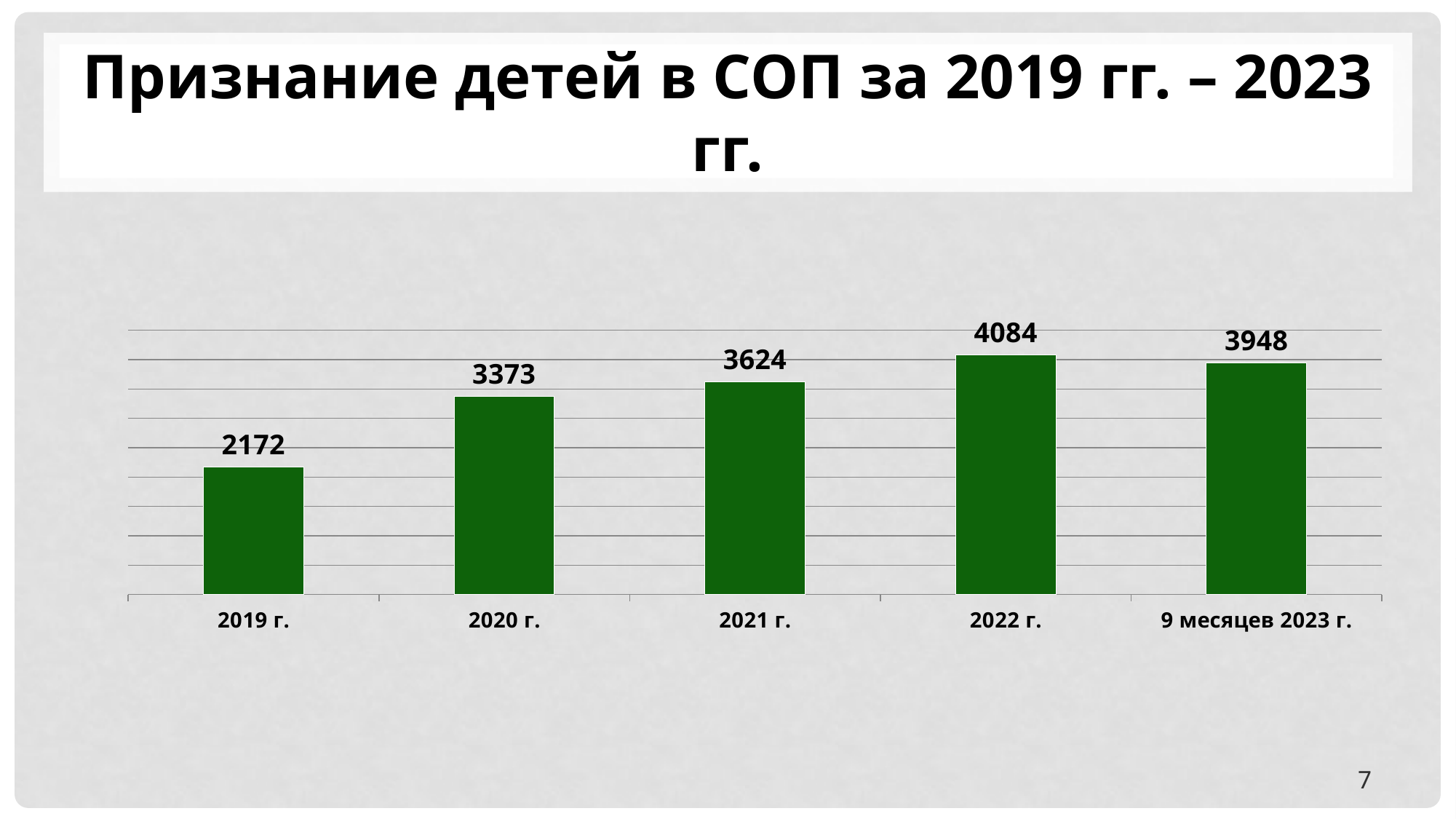
What is the difference between the values for 2022 г. and 2019 г.? 1912 What is the value for 2021 г.? 3624 Do the values rise or fall from 2019 г. to 2022 г.? Rise Which is larger, the value for 2022 г. or the value for 9 месяцев 2023 г.? 2022 г. What kind of chart is shown on the slide? Bar chart What is the value for 9 месяцев 2023 г.? 3948 Which category has the lowest value? 2019 г. What is the value for 2019 г.? 2172 How many categories are shown on the x axis? 5 What is the difference between the values for 2020 г. and 2019 г.? 1201 Which category has the highest value? 2022 г. What colour are the bars in the chart? Green